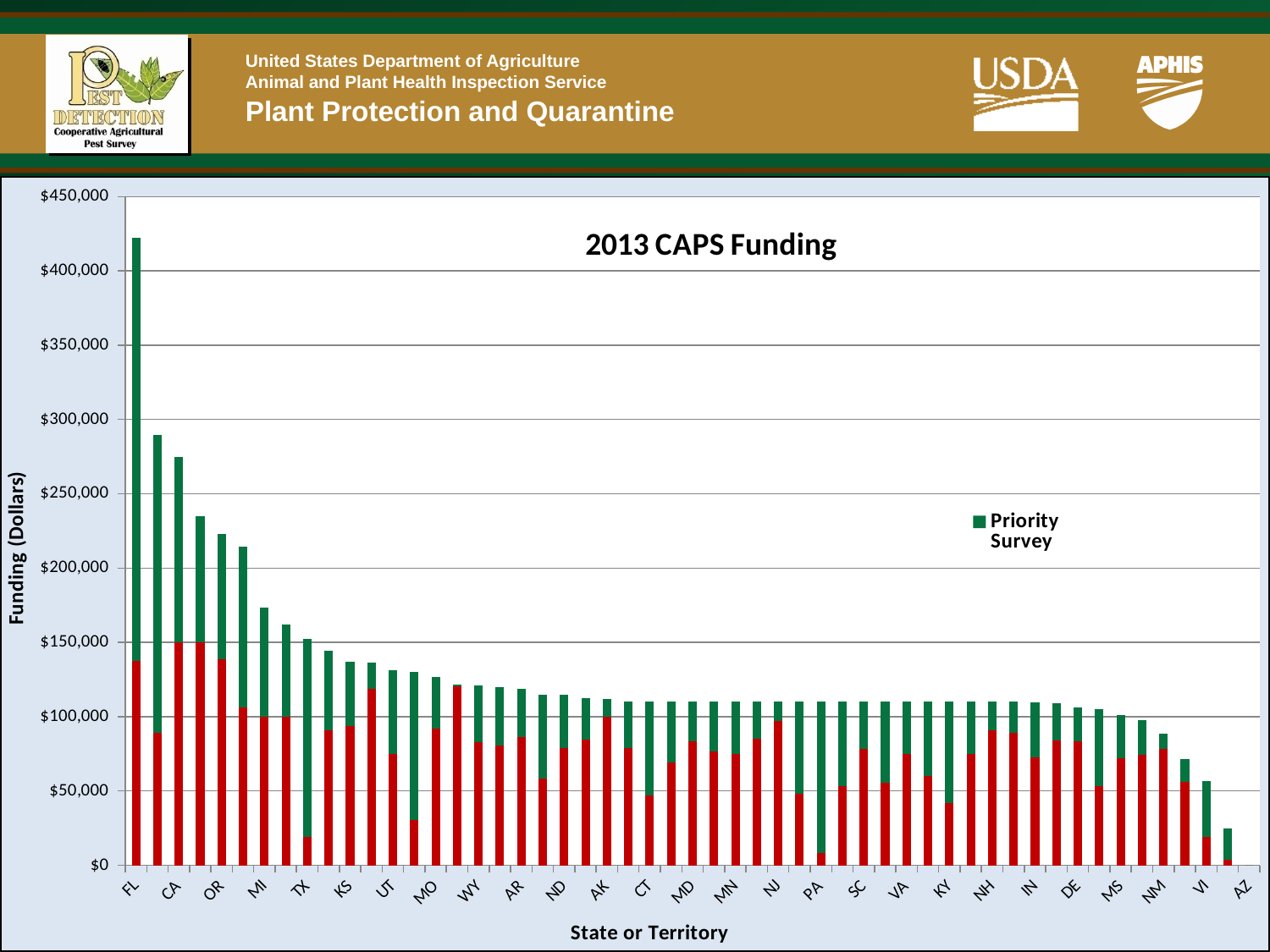
Is the total funding for CA greater or less than $250,000? greater Which state or territory has the lowest total funding? AZ Do the total funding values generally rise or fall moving from left to right along the x axis? Fall Which has the larger total funding, FL or CA? FL What is the label of the y axis? Funding (Dollars) What is the title of the chart? 2013 CAPS Funding Which state or territory has the highest total funding? FL Is the total funding for FL greater or less than $400,000? greater Is the total funding for AZ greater or less than $50,000? less What type of chart is shown on the slide? Bar chart